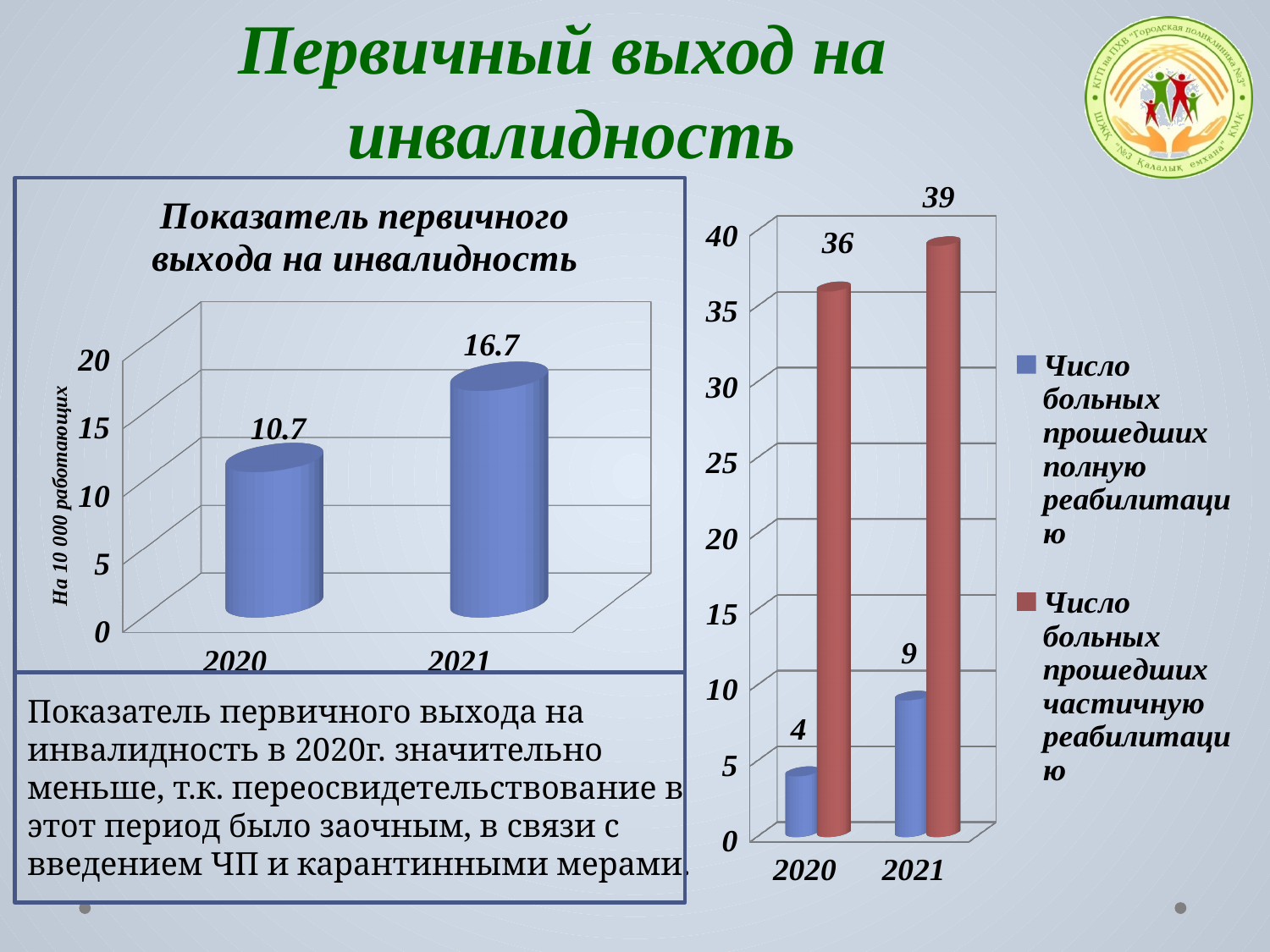
In the chart on the right side of the slide, how many years are shown on the x axis? 2 In the chart titled 'Показатель первичного выхода на инвалидность', what kind of chart is shown? bar chart In the chart titled 'Показатель первичного выхода на инвалидность', what is the difference between the 2021 and 2020 values? 6 In the chart titled 'Показатель первичного выхода на инвалидность', what is the value for 2020? 10.7 In the chart on the right side of the slide, what is the number of patients who completed partial rehabilitation (Число больных прошедших частичную реабилитацию) in 2020? 36 In the chart on the right side of the slide, what is the difference between partial rehabilitation in 2021 and 2020? 3 In the chart titled 'Показатель первичного выхода на инвалидность', which year has the higher value? 2021 In the chart on the right side of the slide, how many series does the legend list? 2 In the chart on the right side of the slide, which is larger in 2020: full rehabilitation or partial rehabilitation? partial rehabilitation In the chart titled 'Показатель первичного выхода на инвалидность', what is the value for 2021? 16.7 In the chart titled 'Показатель первичного выхода на инвалидность', do the values rise or fall from 2020 to 2021? rise In the chart on the right side of the slide, what is the number of patients who completed full rehabilitation (Число больных прошедших полную реабилитацию) in 2021? 9